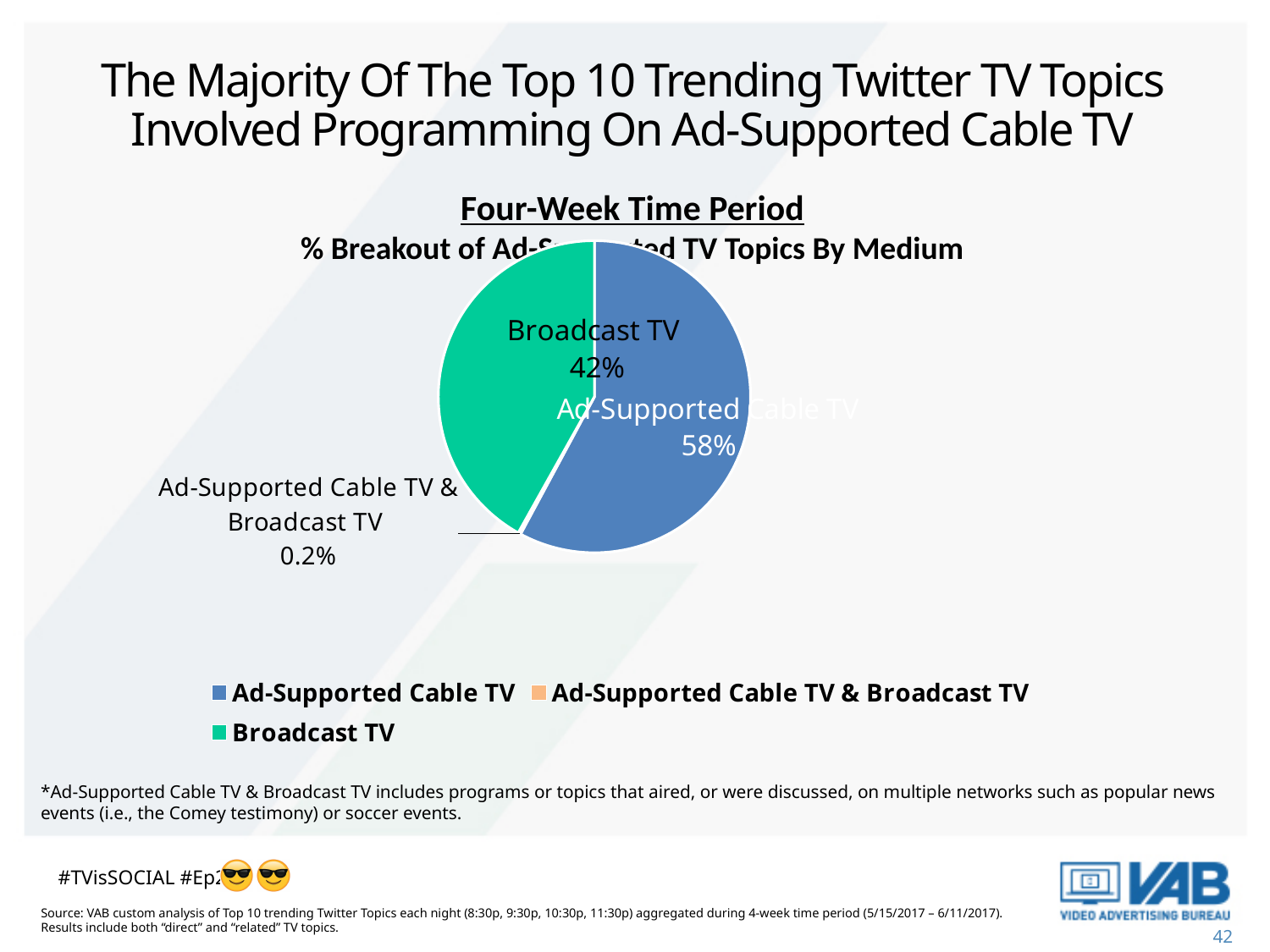
Which slice of the pie is the smallest? Ad-Supported Cable TV & Broadcast TV How many entries does the legend list? 3 What is the underlined heading above the pie chart? Four-Week Time Period What is the difference in percentage points between Ad-Supported Cable TV and Broadcast TV? 16 How many slices does the pie chart have? 3 What share of the pie does Broadcast TV account for? 42% What is the value shown for Ad-Supported Cable TV & Broadcast TV? 0.2% What kind of chart is shown on the slide? Pie chart What colour is the Broadcast TV slice of the pie? Green Which slice of the pie is the largest? Ad-Supported Cable TV Which is larger, the share for Broadcast TV or the share for Ad-Supported Cable TV? Ad-Supported Cable TV What share of the pie does Ad-Supported Cable TV account for? 58%